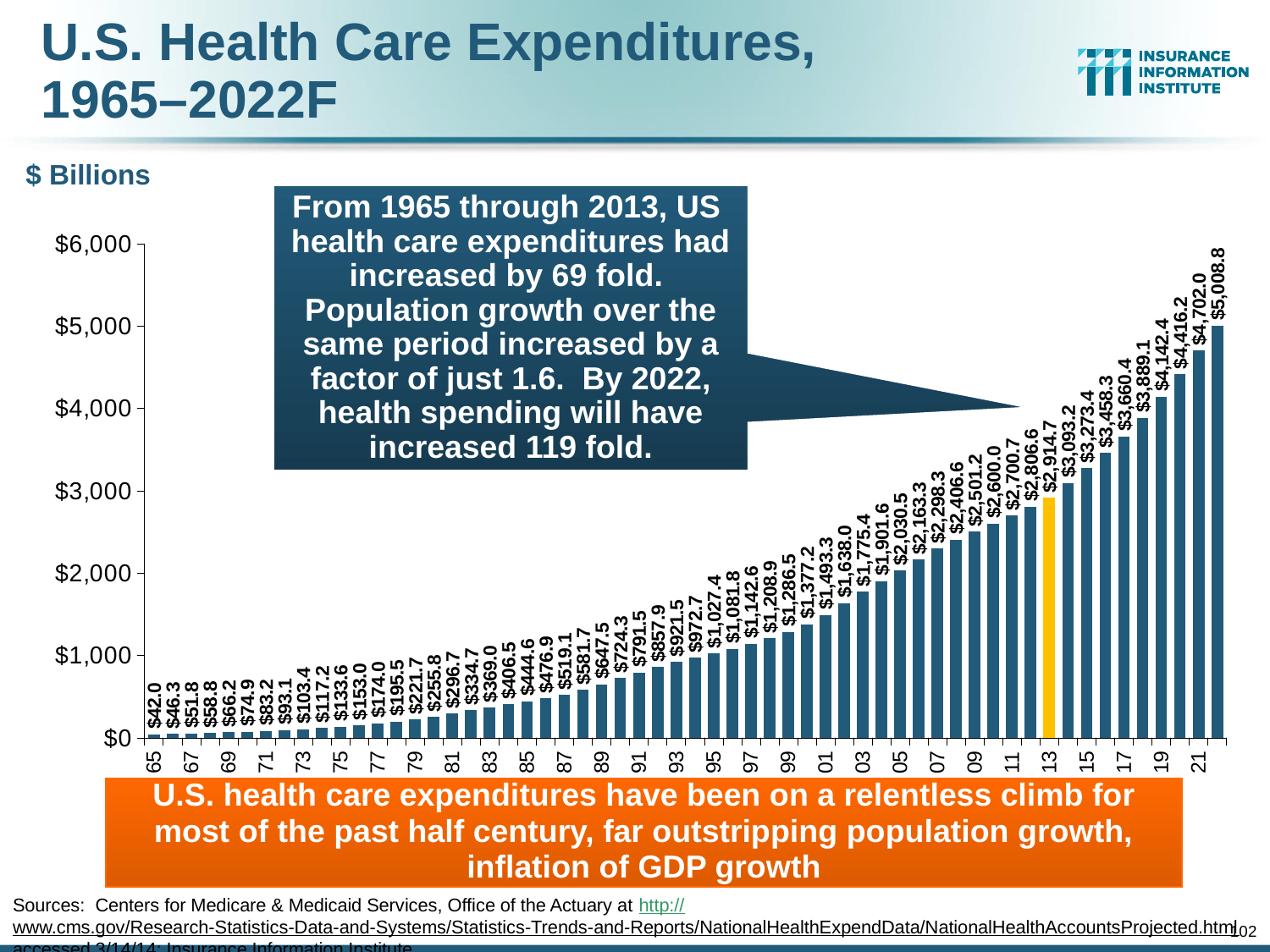
What is the value of the highlighted bar for 2013? $2,914.7 What is the difference between the 2022F value and the 2013 value? $2,094.1 What is the value shown for the last bar, 2022F? $5,008.8 Which year has the lowest health care expenditure value on the chart? 1965 What unit is shown for the y axis of the chart? $ Billions What is the value shown for 2005? $2,030.5 Do the values generally rise or fall from 1965 to 2022? rise Which is larger, the value for 1995 or the value for 2005? 2005 What is the value of U.S. health care expenditures for 1965 (the first bar)? $42.0 How many bars (years) are plotted on the chart? 58 Which year has the highest health care expenditure value on the chart? 2022 What type of chart is shown on the slide? bar chart